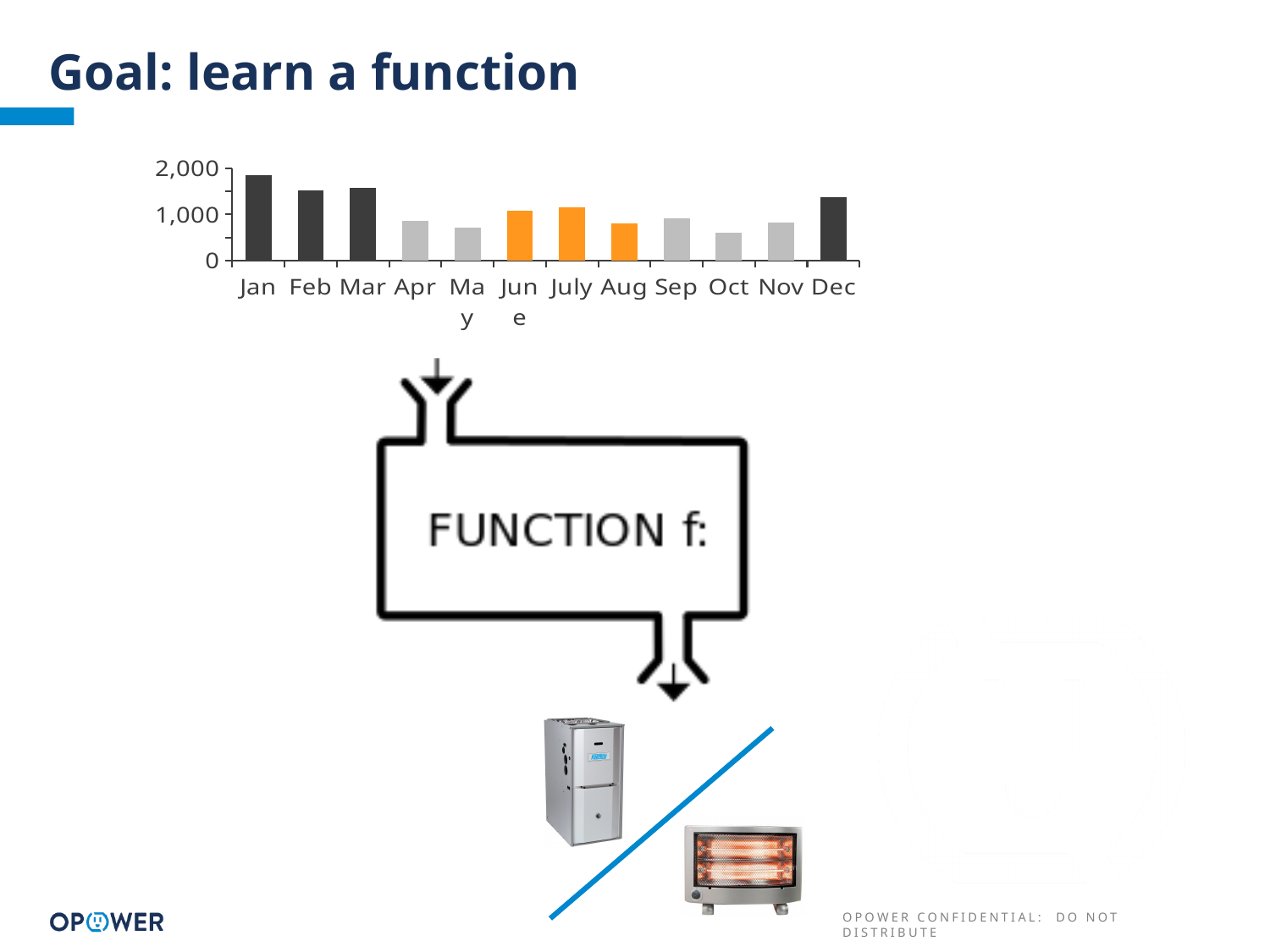
Which month has the highest bar in the chart? Jan Is the value for Oct greater or less than 1,000? less How many months are plotted on the x axis of the chart? 12 Is the value for Jan greater or less than 1,000? greater Which is larger, the value for Jan or the value for Dec? Jan Is the value for Apr greater or less than 1,000? less Which months' bars are coloured orange in the chart? June, July, Aug Which month has the lowest bar in the chart? Oct Which is larger, the value for Mar or the value for Apr? Mar What kind of chart is shown on the slide? bar chart Do the bar values rise or fall from Jan to May? fall